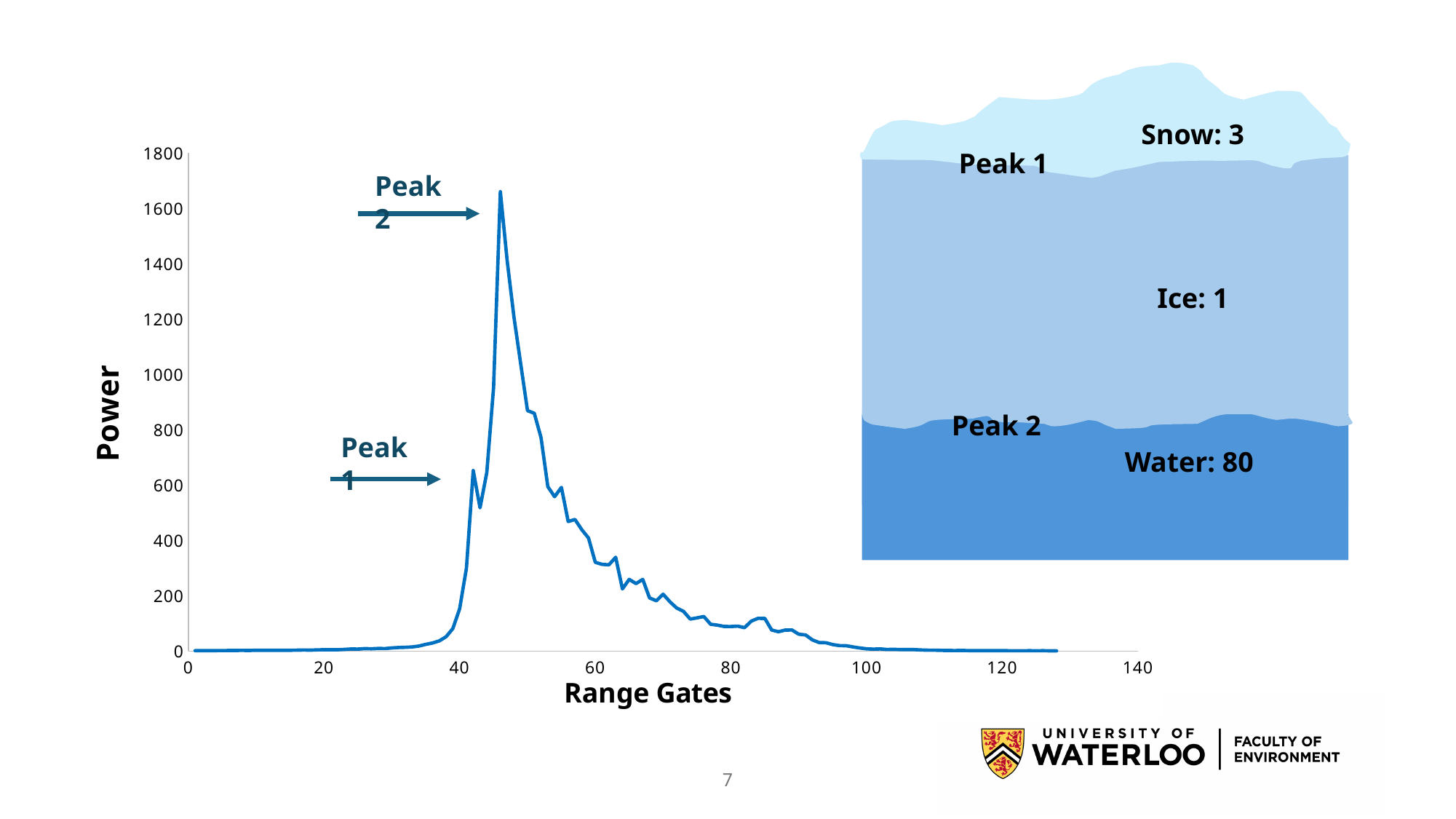
Is the power at Peak 1 greater or less than 400? greater Is the power at Peak 2 greater or less than 1400? greater What is the highest tick value shown on the y axis? 1800 Is the power at range gate 20 greater or less than 200? less What is the label of the y axis of the chart? Power Does the power rise or fall along the x axis between range gate 30 and range gate 45? rise Does the power rise or fall along the x axis between range gate 60 and range gate 100? fall Which of the two labelled peaks, Peak 1 or Peak 2, has the higher power? Peak 2 What kind of chart is shown on the slide? line chart Is the highest point of the line greater or less than 1600? greater What is the label of the x axis of the chart? Range Gates